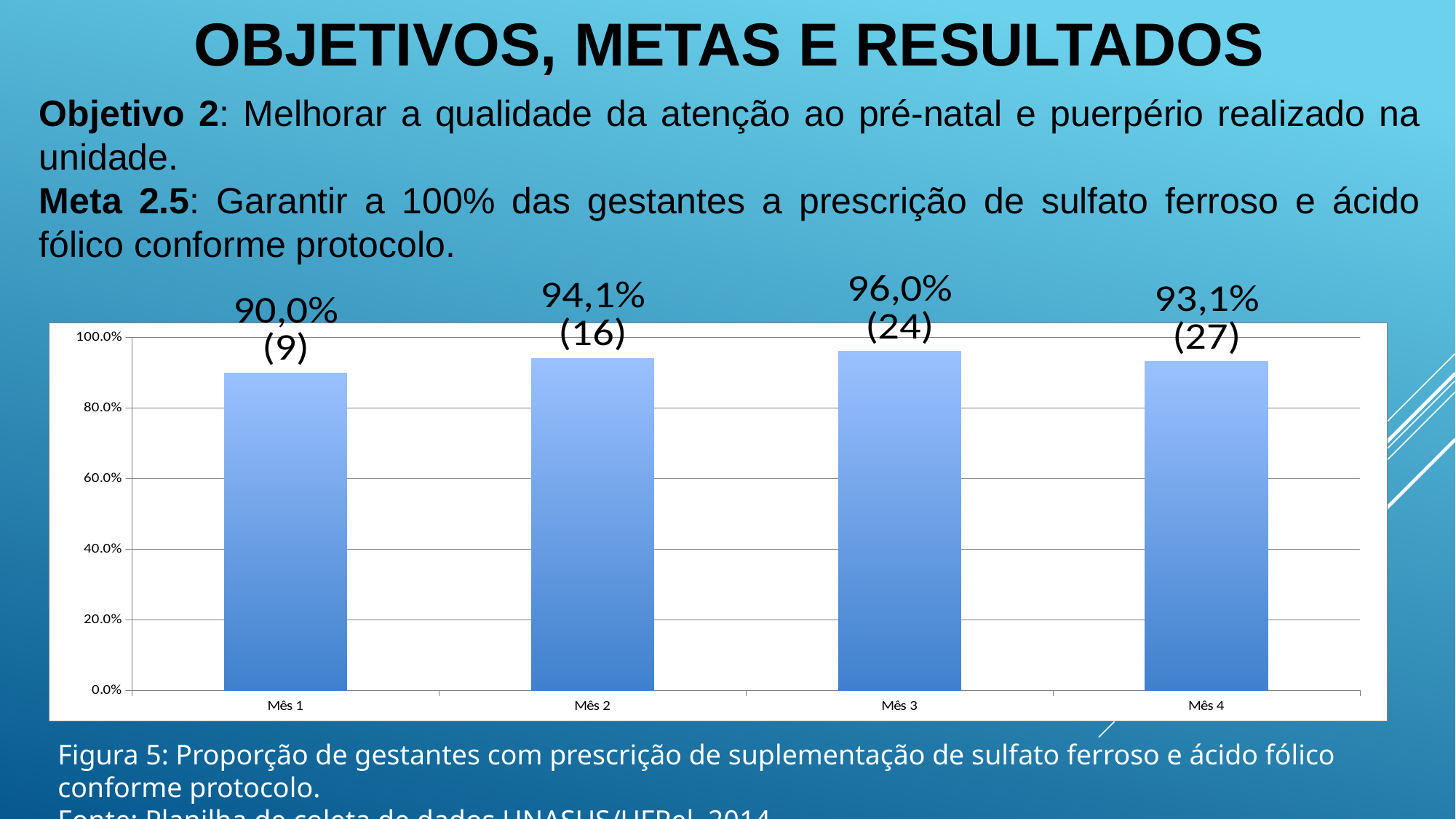
What kind of chart is shown on the slide? Bar chart How many months are shown on the x axis? 4 What is the count shown in parentheses for Mês 2? 16 Is the value for Mês 1 greater or less than 80.0%? greater What is the figure number given in the caption below the chart? Figura 5 What is the difference in percentage points between Mês 3 and Mês 1? 6,0 Which is larger, the percentage for Mês 2 or for Mês 4? Mês 2 Which month has the highest percentage? Mês 3 What is the count shown in parentheses for Mês 4? 27 Which month has the lowest percentage? Mês 1 What is the percentage value shown for Mês 1? 90,0% What is the percentage value shown for Mês 3? 96,0%